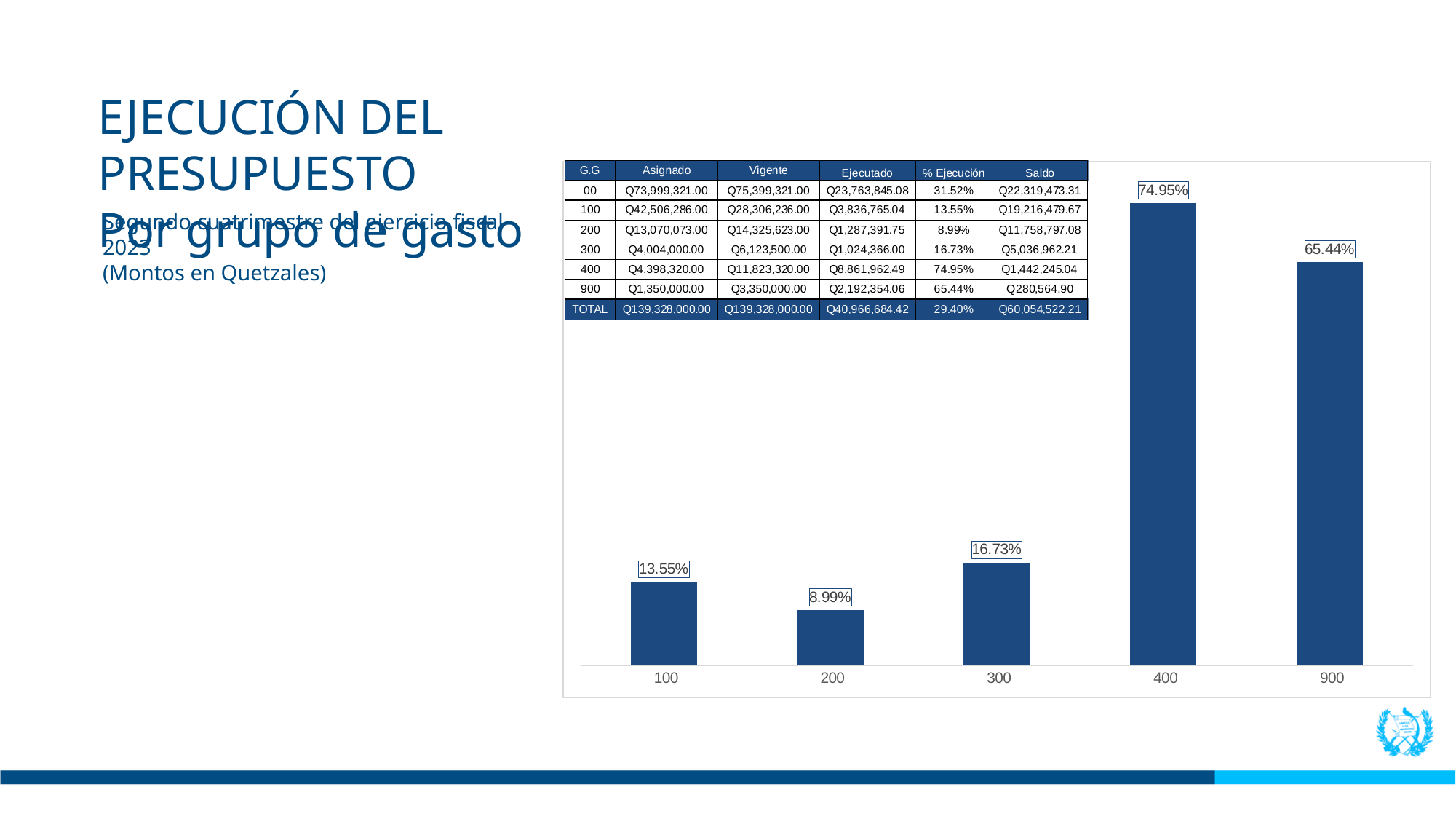
What is the difference between the values for category 400 and category 900 in the bar chart? 9.51% What colour are the bars in the chart? Dark blue What type of chart is shown on the slide? Bar chart What is the value shown for category 100 in the bar chart? 13.55% What is the value shown for category 200 in the bar chart? 8.99% What is the value shown for category 900 in the bar chart? 65.44% What is the value shown for category 400 in the bar chart? 74.95% Which is larger in the bar chart, the value for category 300 or the value for category 200? 300 Which category has the lowest bar in the chart? 200 Which category has the highest bar in the chart? 400 What is the difference between the values for category 300 and category 100 in the bar chart? 3.18% How many bars are plotted in the chart? 5